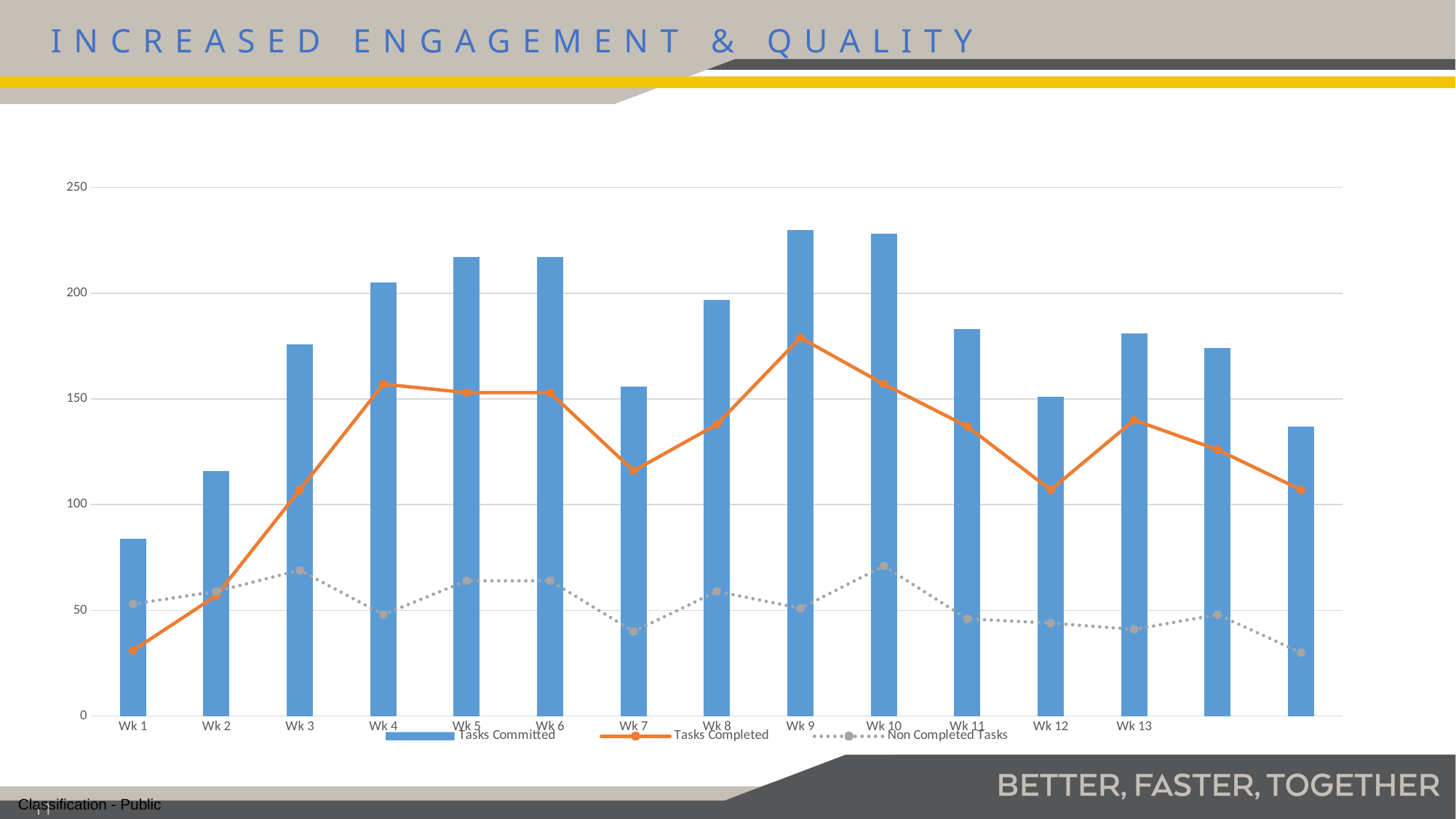
What kind of chart is shown on the slide? A combined bar and line chart Which is larger, the Tasks Committed bar for Wk 2 or for Wk 3? Wk 3 Is the Tasks Committed value for Wk 1 greater or less than 100? less Is the Tasks Committed value for Wk 5 greater or less than 200? greater Which series is drawn as blue bars? Tasks Committed Which series is drawn as a grey dotted line? Non Completed Tasks Is the Tasks Completed value for Wk 9 greater or less than 150? greater In which week does the Tasks Completed line reach its highest point? Wk 9 Which week has the lowest Tasks Committed bar? Wk 1 How many series does the legend list? 3 In which week is the Tasks Completed value lowest? Wk 1